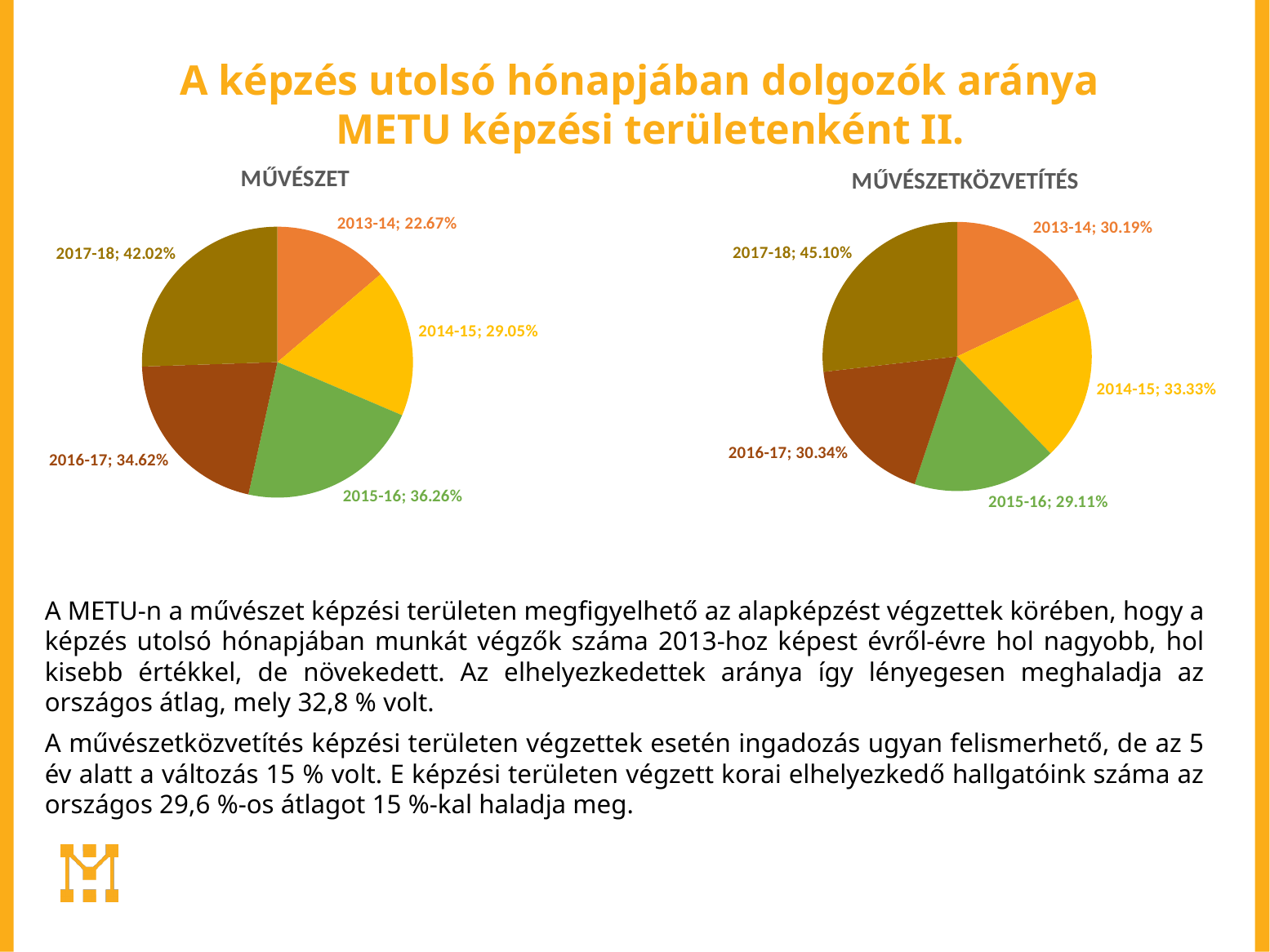
In the MŰVÉSZETKÖZVETÍTÉS chart, which year has the highest value? 2017-18 In the MŰVÉSZET chart, which year has the lowest value? 2013-14 In the MŰVÉSZETKÖZVETÍTÉS chart, what is the value for 2014-15? 33.33% In the MŰVÉSZETKÖZVETÍTÉS chart, which is larger, the value for 2014-15 or the value for 2015-16? 2014-15 In the MŰVÉSZETKÖZVETÍTÉS chart, what is the value for 2016-17? 30.34% In the MŰVÉSZET chart, what is the difference between the values for 2017-18 and 2013-14? 19.35% What kind of chart is the MŰVÉSZETKÖZVETÍTÉS chart? Pie chart In the MŰVÉSZET chart, which year has the highest value? 2017-18 In the MŰVÉSZET chart, what is the value for 2013-14? 22.67% In the MŰVÉSZETKÖZVETÍTÉS chart, which year has the lowest value? 2015-16 In the MŰVÉSZET chart, what is the value for 2015-16? 36.26% How many slices does the MŰVÉSZET chart have? 5